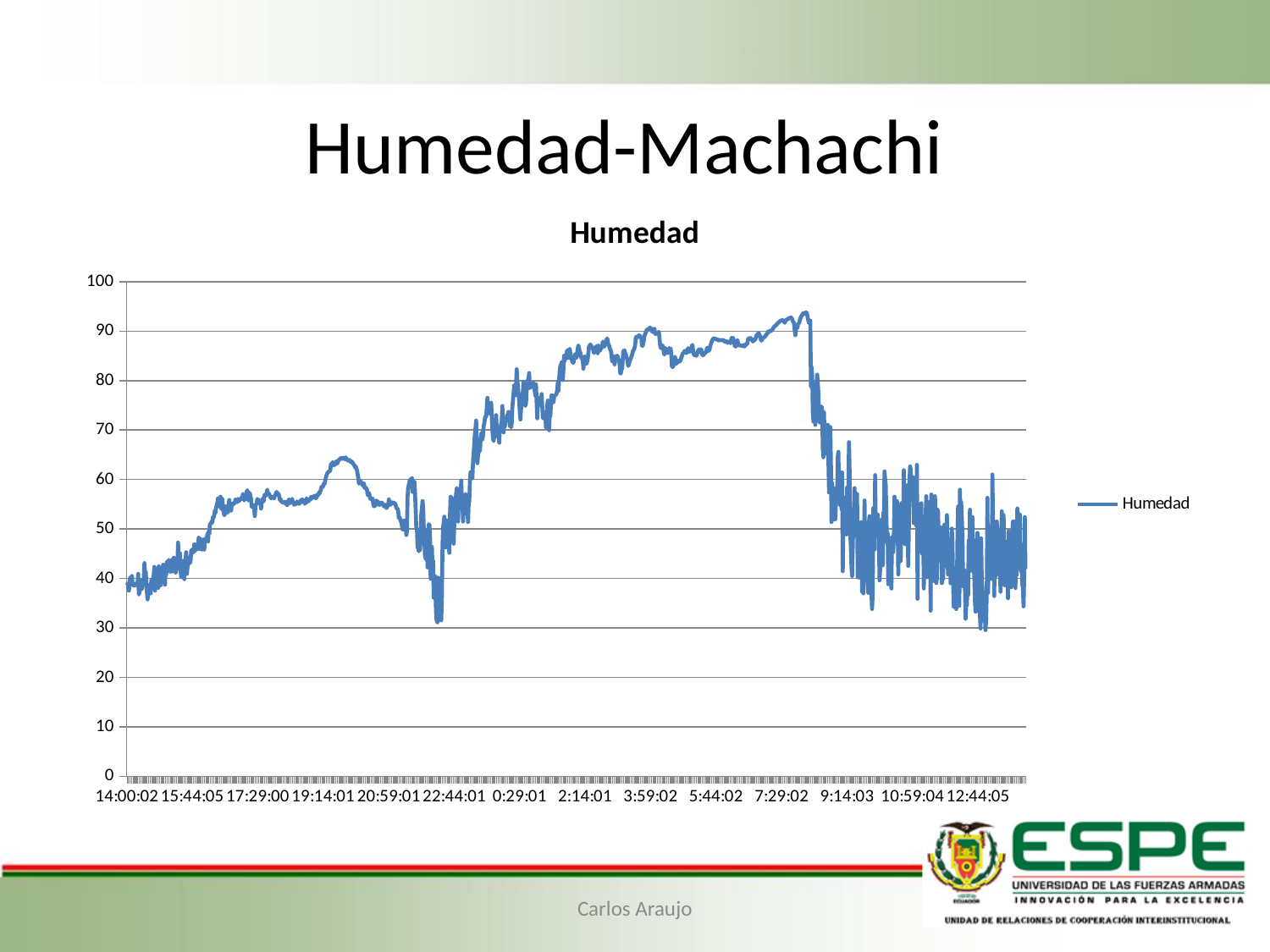
What is the title of the chart? Humedad Is the Humedad value at 7:29:02 greater or less than 80? greater Is the Humedad value at 2:14:01 greater or less than 80? greater What kind of chart is shown on the slide? line chart Is the Humedad value at 14:00:02 greater or less than 50? less Does the Humedad value generally rise or fall between 14:00:02 and 2:14:01? rise Does the Humedad value rise or fall between 7:29:02 and 9:14:03? fall What is the name of the series shown in the legend? Humedad How many series does the legend list? 1